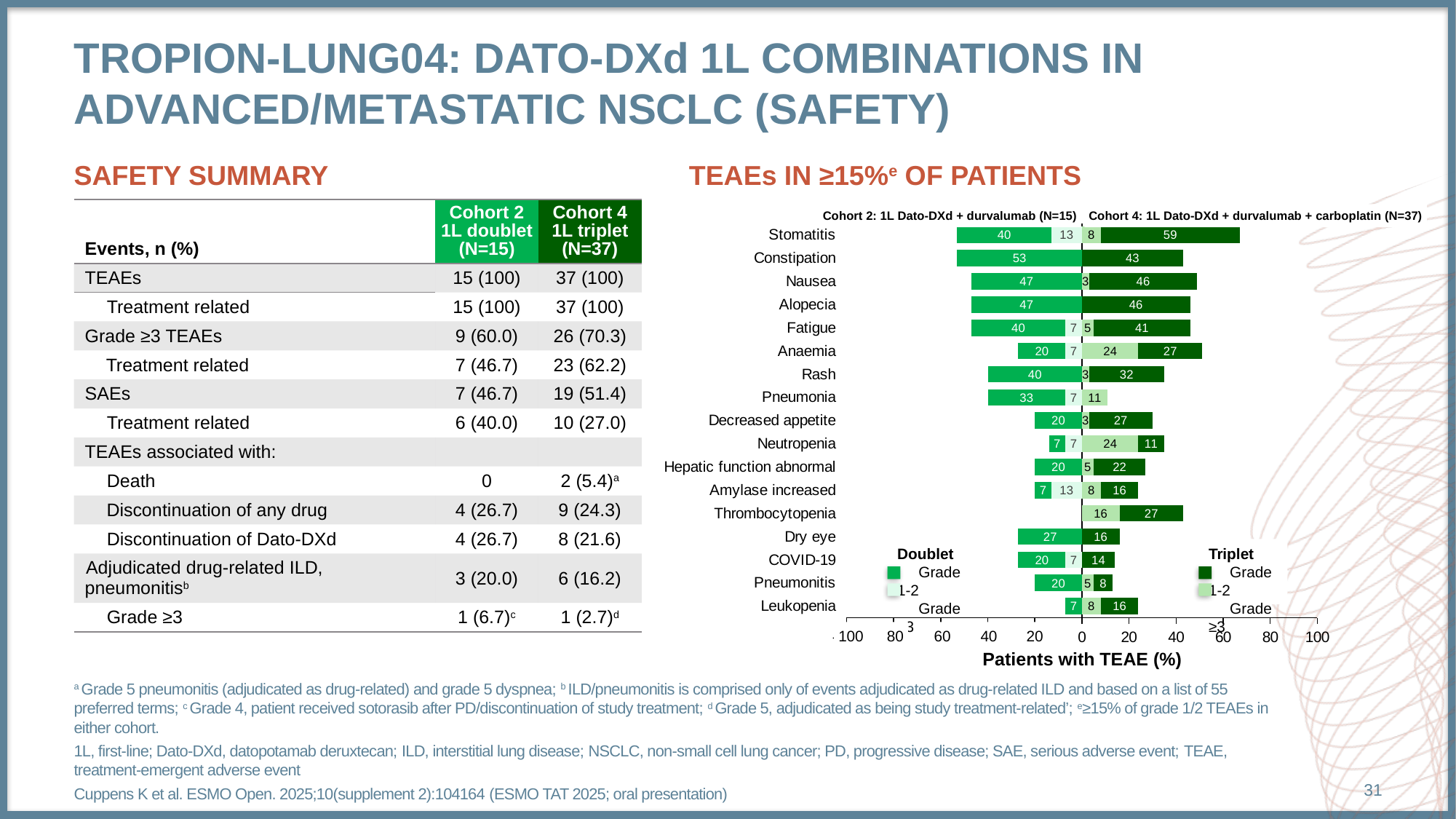
In the chart, what is the Grade 1-2 value for stomatitis in Cohort 4 (triplet)? 59 In the chart, what is the difference between the Grade 1-2 alopecia value in Cohort 2 (47) and in Cohort 4 (46)? 1 In the chart, what is the Grade ≥3 value for thrombocytopenia in Cohort 4 (triplet)? 16 What kind of chart is used to show TEAEs in ≥15% of patients? bar chart In the chart, which TEAE has the highest Grade 1-2 value in Cohort 2 (doublet)? Constipation In the chart, what is the Grade ≥3 value for amylase increased in Cohort 2 (doublet)? 13 In the chart, what is the Grade 1-2 value for constipation in Cohort 2 (doublet)? 53 In the chart, what is the total percentage of patients with stomatitis in Cohort 2 (doublet), adding Grade 1-2 and Grade ≥3? 53 In the chart, which cohort has the larger Grade ≥3 value for neutropenia, Cohort 2 (doublet) or Cohort 4 (triplet)? Cohort 4 (triplet) In the chart, what is the total percentage of patients with anaemia in Cohort 4 (triplet), adding Grade ≥3 and Grade 1-2? 51 How many TEAE categories are listed on the y axis of the chart? 17 What is the title of the x axis of the chart? Patients with TEAE (%)